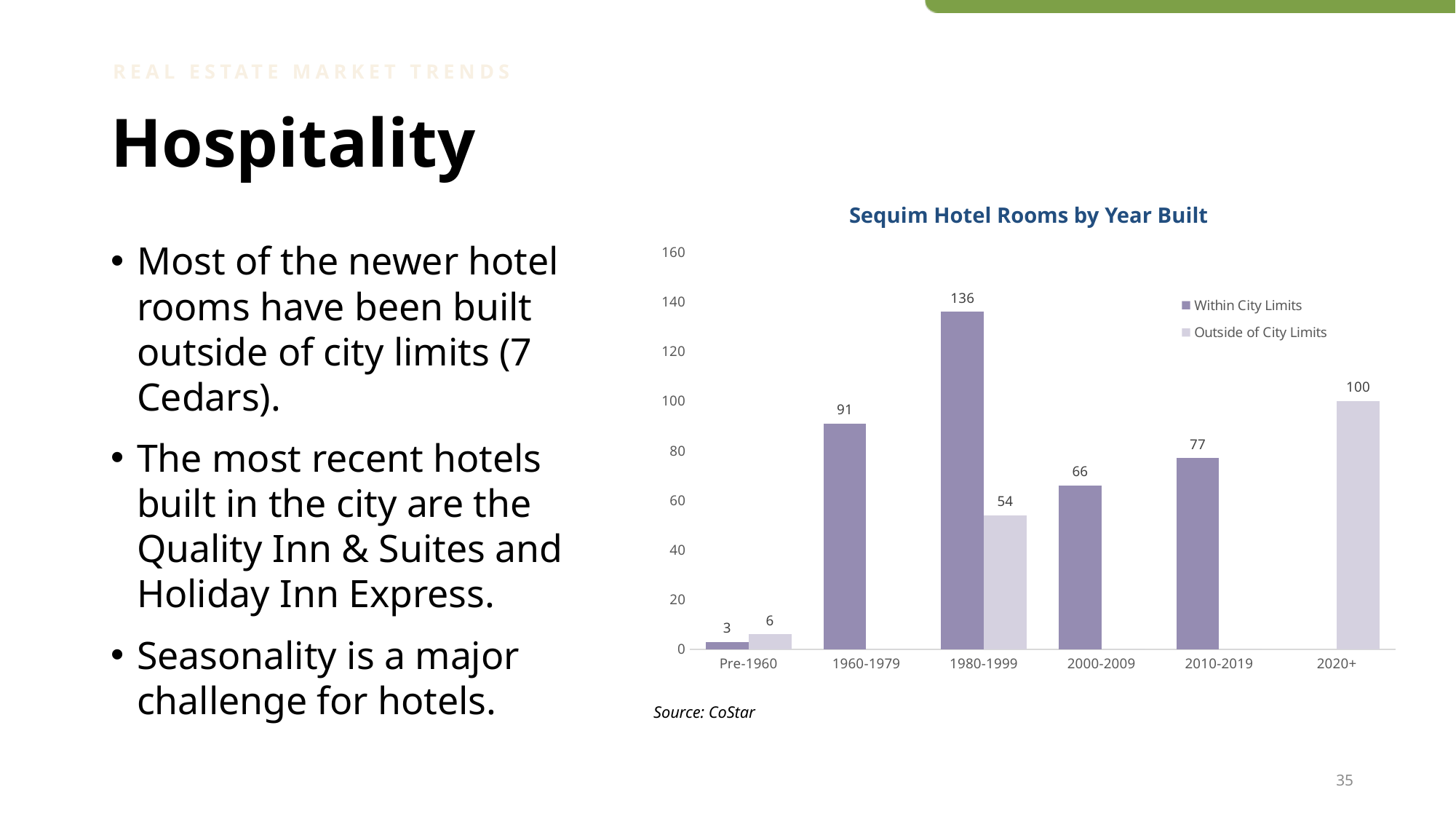
What is the value for Within City Limits in 2010-2019? 77 Is the value for Within City Limits in 1960-1979 greater or less than 80? greater Which year-built category has the highest value for Within City Limits? 1980-1999 What is the title of the chart? Sequim Hotel Rooms by Year Built Which is larger in Pre-1960: Within City Limits or Outside of City Limits? Outside of City Limits What is the difference between Within City Limits and Outside of City Limits in 1980-1999? 82 What is the value for Outside of City Limits in 2020+? 100 How many year-built categories are shown on the x axis? 6 Which year-built category has the lowest value for Within City Limits? Pre-1960 What is the value for Within City Limits in 1980-1999? 136 How many series does the legend list? 2 What kind of chart is shown on the slide? Bar chart